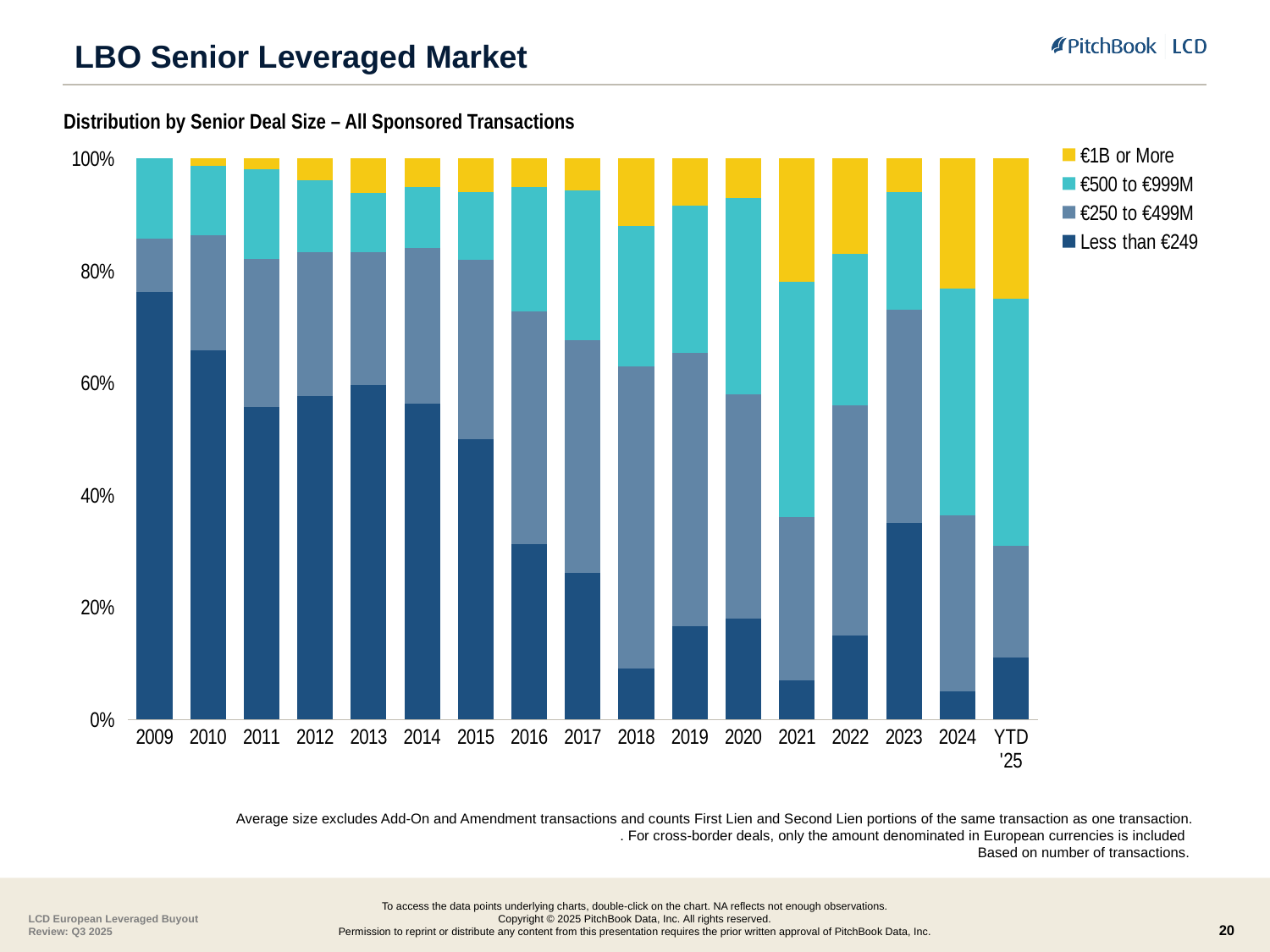
Does the 'Less than €249' share rise or fall from 2009 to 2015? Fall Is the 'Less than €249' share in 2015 greater or less than 40%? greater Is the 'Less than €249' share in 2009 greater or less than 60%? greater Is the 'Less than €249' share in 2024 greater or less than 20%? less What is the title of the chart? Distribution by Senior Deal Size – All Sponsored Transactions How many categories (years) are shown on the x axis? 17 Which is larger, the 'Less than €249' share in 2009 or in 2023? 2009 How many series does the legend list? 4 Which colour represents the '€1B or More' series? Yellow What kind of chart is shown on the slide? Stacked bar chart What does each stacked bar total? 100% Which year has the largest share for 'Less than €249'? 2009